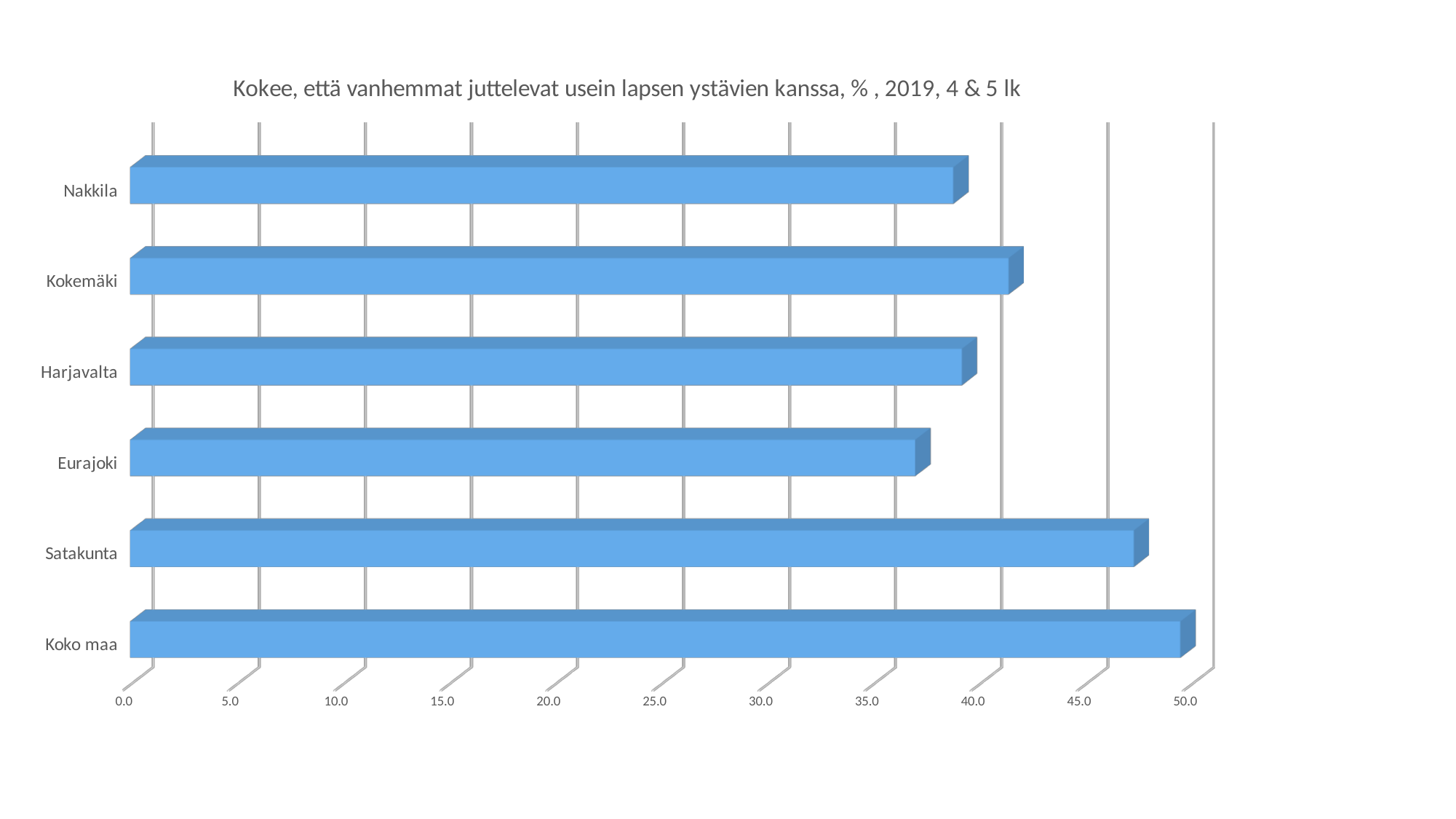
Which category has the lowest value? Eurajoki Is the value for Koko maa greater or less than 45.0? greater Is the value for Eurajoki greater or less than 35.0? greater Which category has the highest value? Koko maa How many categories are shown on the chart? 6 What is the title of the chart? Kokee, että vanhemmat juttelevat usein lapsen ystävien kanssa, % , 2019, 4 & 5 lk Is the value for Nakkila greater or less than 40.0? less Which is larger, the value for Kokemäki or the value for Eurajoki? Kokemäki Which is larger, the value for Satakunta or the value for Kokemäki? Satakunta What kind of chart is shown on the slide? bar chart